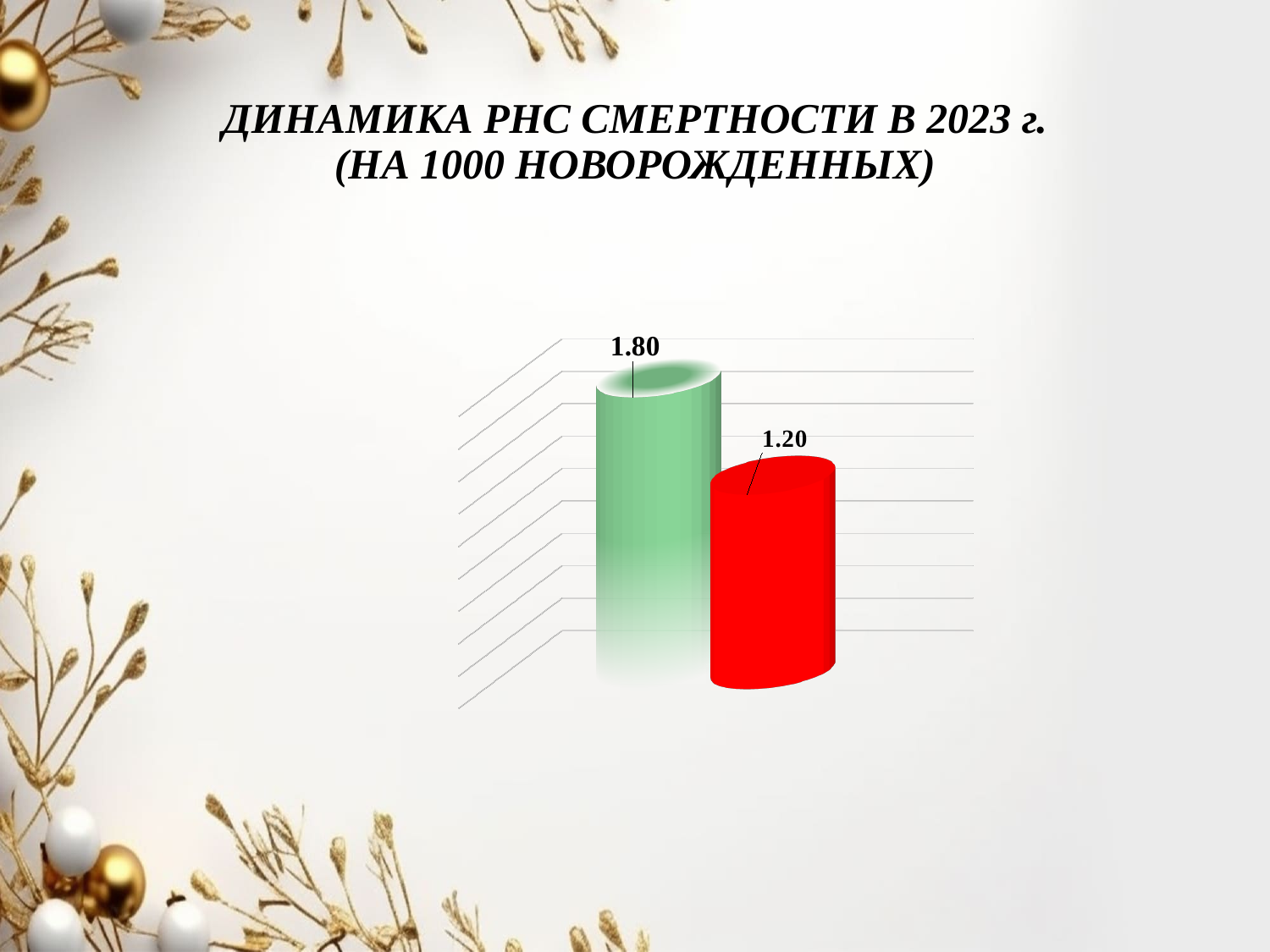
What is the value shown on the red (right) bar? 1.20 How many bars are plotted on the chart? 2 Which bar has the highest value, the green one or the red one? the green bar What colour is the bar with the value 1.20? red Is the value of the red bar larger or smaller than the value of the green bar? smaller What is the difference between the values of the green bar and the red bar? 0.60 What is the value shown on the green (left) bar? 1.80 Do the values rise or fall from the left bar to the right bar? fall What is the title of the chart on the slide? ДИНАМИКА РНС СМЕРТНОСТИ В 2023 г. (НА 1000 НОВОРОЖДЕННЫХ) What kind of chart is shown on the slide? bar chart Which bar has the lowest value, the green one or the red one? the red bar